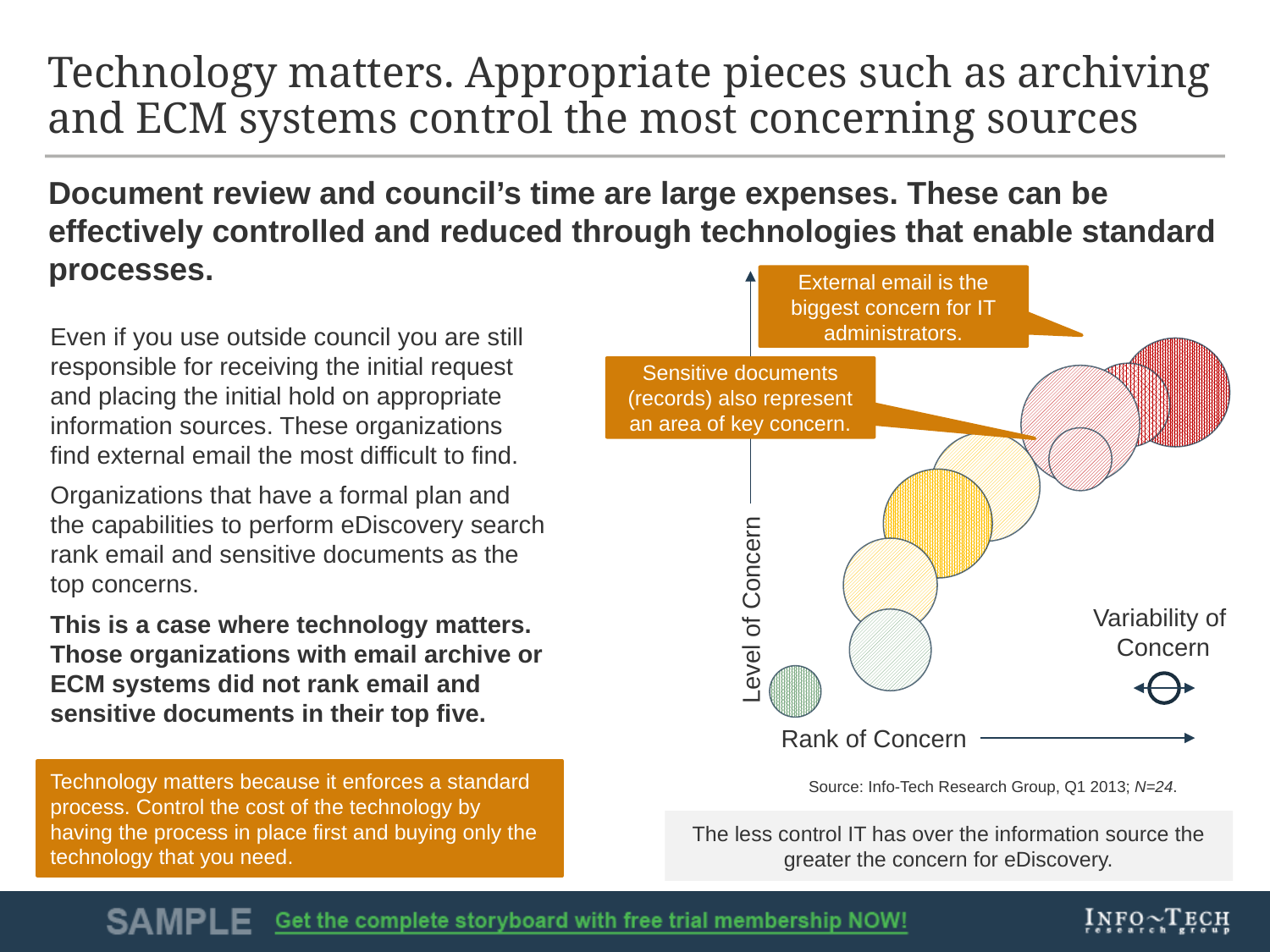
What kind of chart is shown on the slide? Bubble chart What does the size of each bubble in the chart represent? Variability of Concern According to the chart's callout, which information source is the biggest concern for IT administrators? External email What is the label of the vertical axis of the chart? Level of Concern Do the bubbles rise or fall in level of concern as rank of concern increases along the x axis? Rise